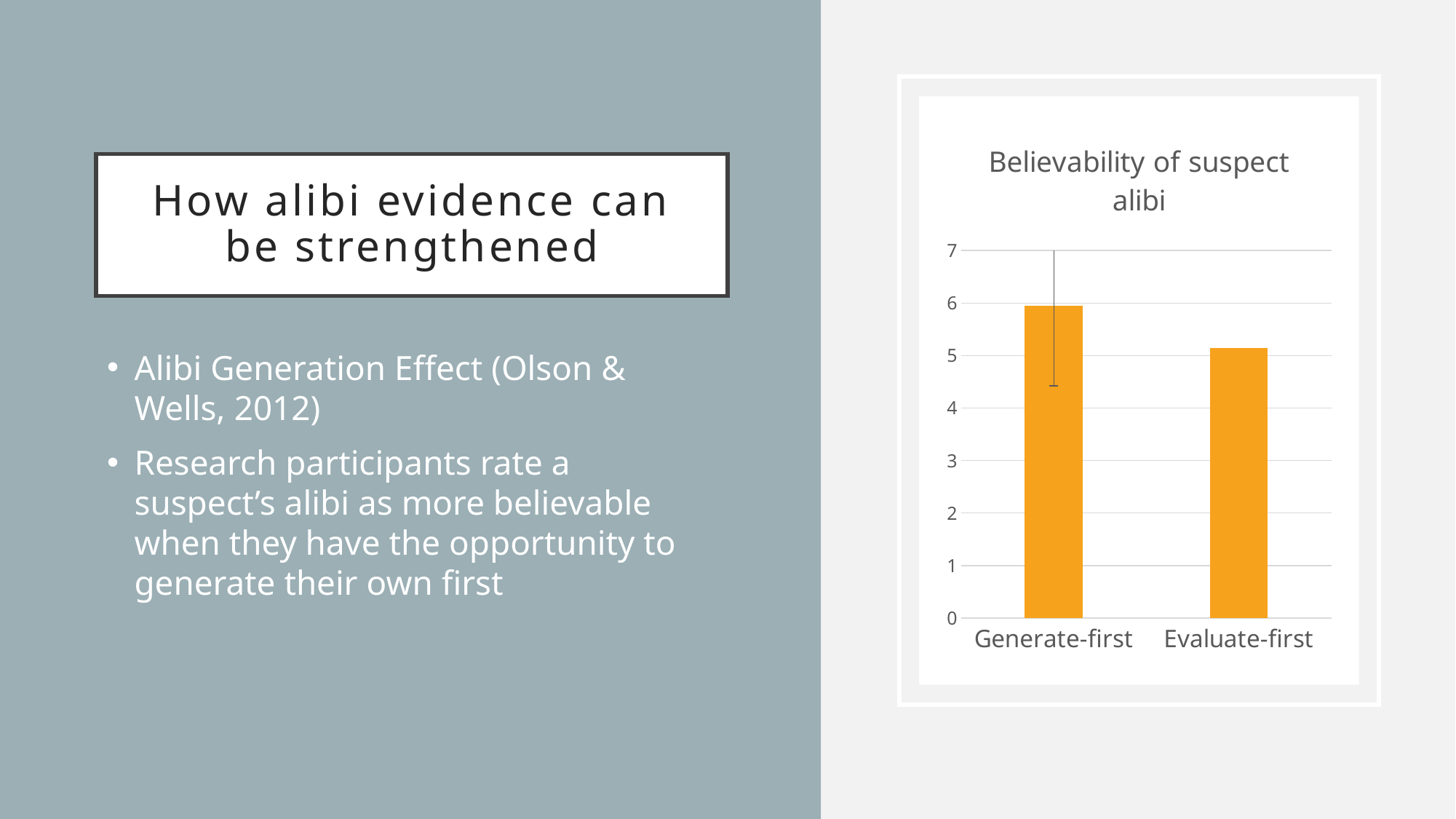
Is the value for Evaluate-first greater or less than 4? greater What is the title of the chart? Believability of suspect alibi How many categories are plotted in the chart? 2 Which category's bar has an error bar drawn on it? Generate-first What is the highest value shown on the vertical axis of the chart? 7 Is the value for Evaluate-first greater or less than 6? less Is the value for Generate-first greater or less than 5? greater Do the values rise or fall from Generate-first to Evaluate-first? fall Which is larger, the value for Generate-first or the value for Evaluate-first? Generate-first Which category has the lowest believability rating? Evaluate-first What kind of chart is shown on the slide? bar chart Which category has the highest believability rating? Generate-first